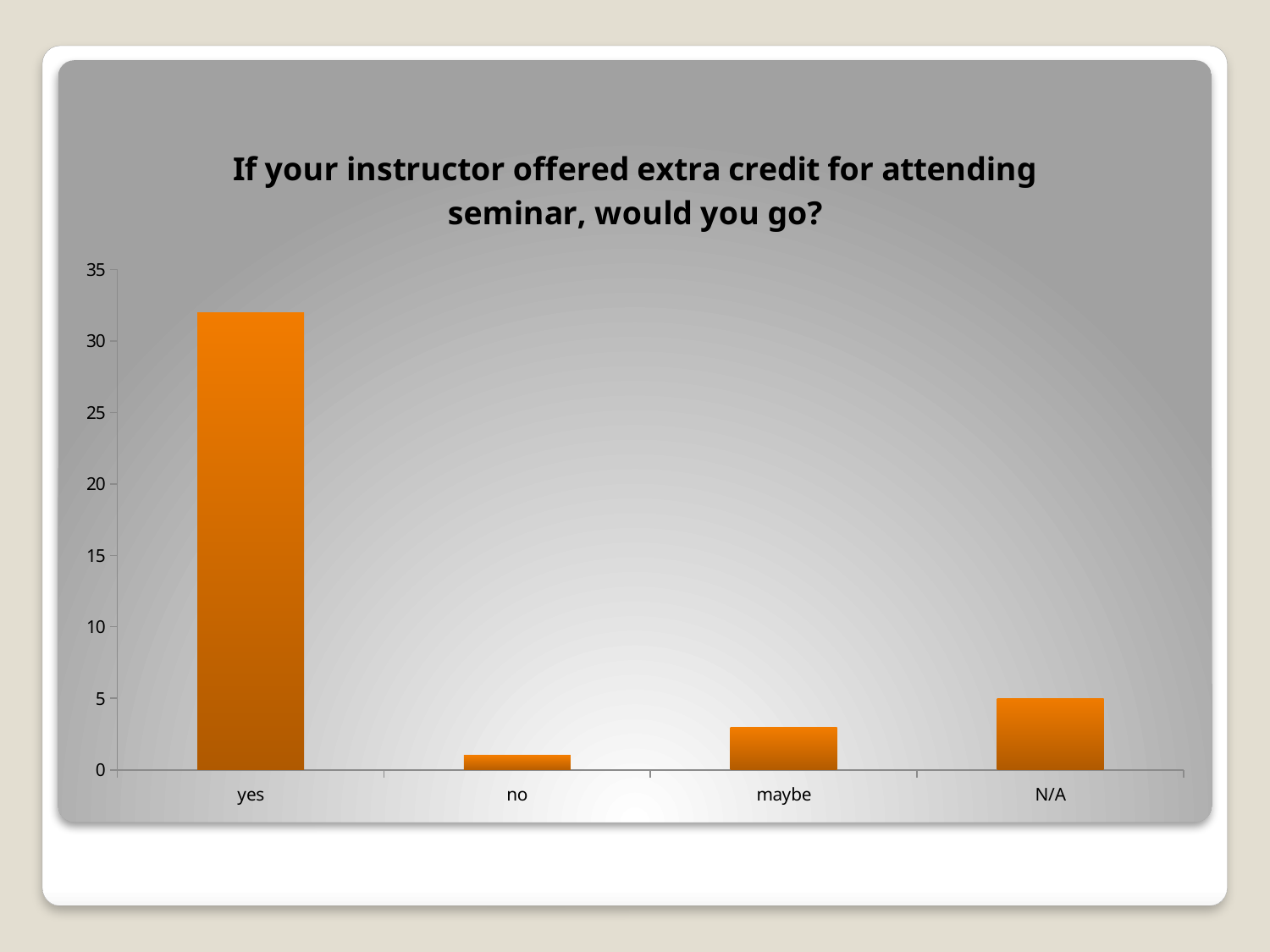
What colour are the bars in the chart? orange What is the value for N/A? 5 Is the value for maybe greater or less than 5? less Which response category has the lowest bar? no Which response category has the highest bar? yes Which is larger, the value for maybe or the value for no? maybe Is the value for no greater or less than 5? less What kind of chart is shown on the slide? bar chart How many response categories are shown on the x axis? 4 Is the value for yes greater or less than 30? greater Which is larger, the value for N/A or the value for maybe? N/A What is the title of the chart? If your instructor offered extra credit for attending seminar, would you go?